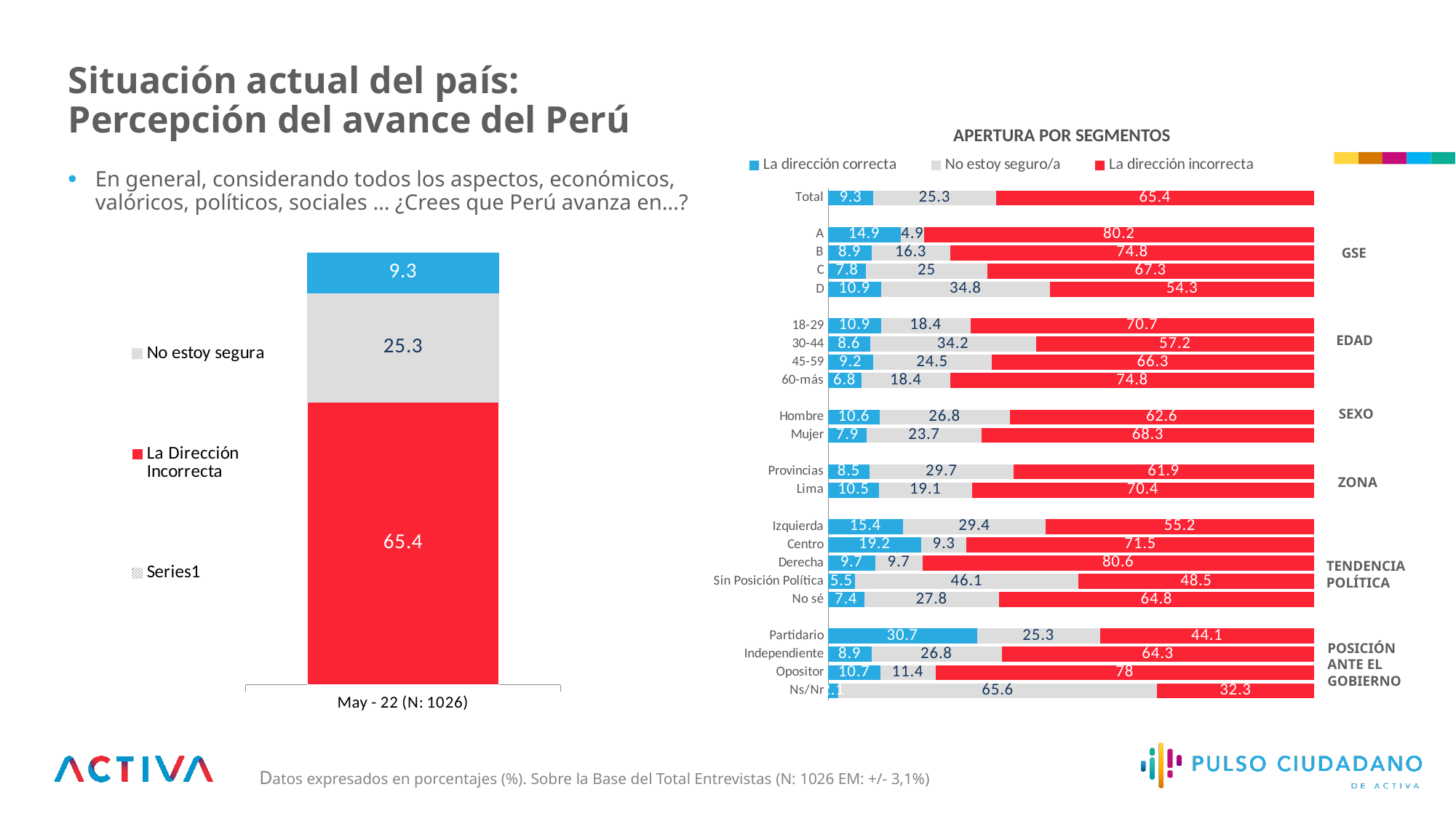
On the left chart, what is the value of the 'No estoy segura' segment? 25.3 On the 'APERTURA POR SEGMENTOS' chart, which category has the lowest 'La dirección incorrecta' value? Ns/Nr On the left chart, what is the difference between the 'La Dirección Incorrecta' value and the 'No estoy segura' value? 40.1 On the left chart, what is the value of the 'La Dirección Incorrecta' segment for May - 22? 65.4 On the 'APERTURA POR SEGMENTOS' chart, what is the difference between the 'La dirección incorrecta' values for Hombre and Mujer? 5.7 On the 'APERTURA POR SEGMENTOS' chart, what is the 'No estoy seguro/a' value for 'Sin Posición Política'? 46.1 On the 'APERTURA POR SEGMENTOS' chart, which category has the highest 'La dirección correcta' value? Partidario On the 'APERTURA POR SEGMENTOS' chart, which is larger: the 'La dirección incorrecta' value for Lima or for Provincias? Lima What kind of chart is the left chart? bar chart On the 'APERTURA POR SEGMENTOS' chart, how many series does the legend list? 3 On the 'APERTURA POR SEGMENTOS' chart, what is the 'La dirección incorrecta' value for segment A? 80.2 On the 'APERTURA POR SEGMENTOS' chart, what is the 'La dirección correcta' value for Centro? 19.2